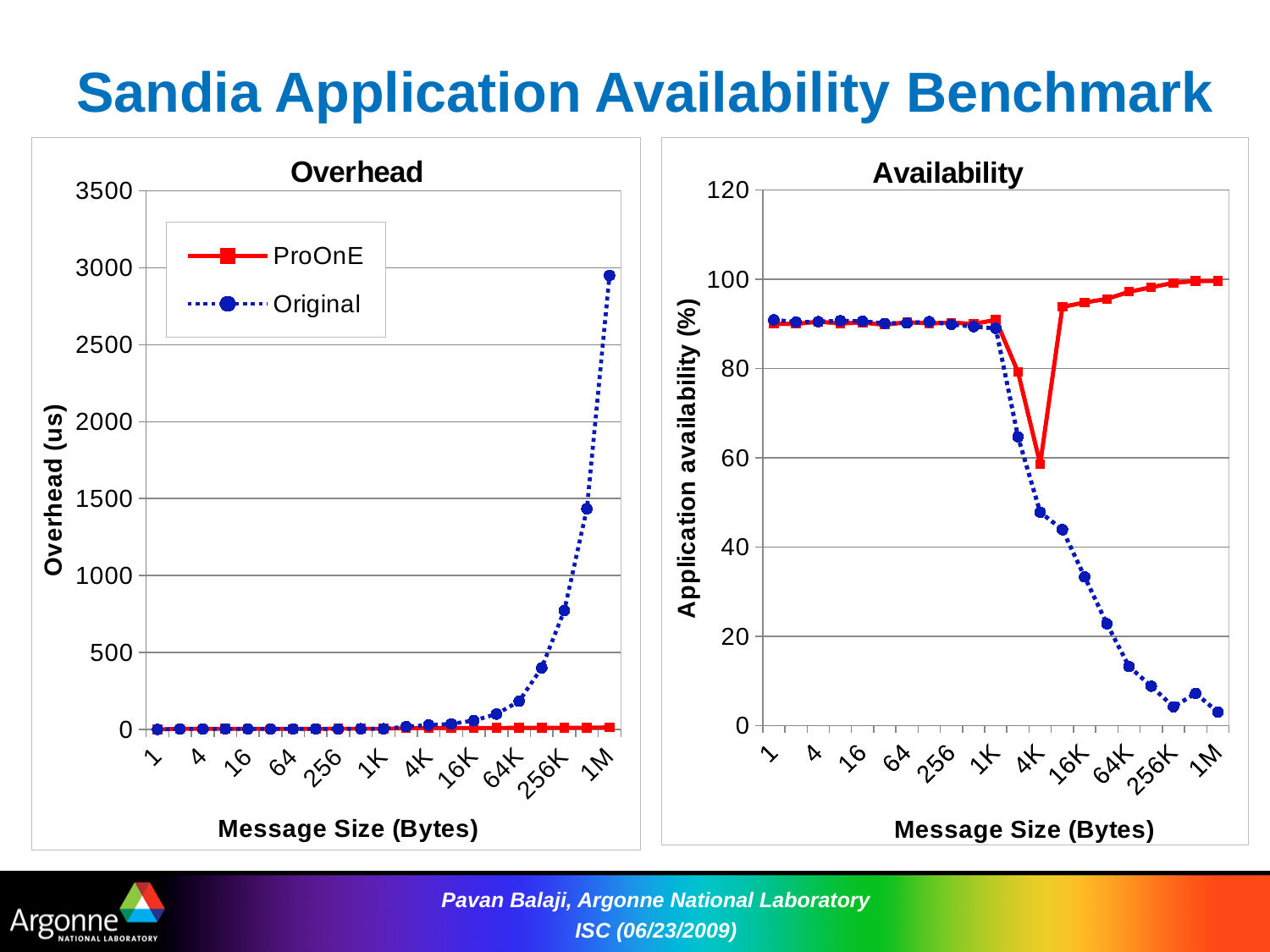
In the Overhead chart, is the Original value at message size 1M greater or less than 2500? greater In the Availability chart, does the Original series rise or fall as message size increases along the x axis? fall What is the y-axis label of the Availability chart? Application availability (%) In the Availability chart, is the Original value at message size 1M greater or less than 20? less In the Overhead chart, is the Original value at message size 256K greater or less than 1000? less In the Overhead chart, which series has the larger value at message size 1M, ProOnE or Original? Original How many message-size tick labels are shown on the x axis of the Availability chart? 11 What kind of chart is the Overhead chart on the left? line chart In the Overhead chart, does the Original series rise or fall as message size increases along the x axis? rise In the Availability chart, which series has the larger value at message size 1M, ProOnE or Original? ProOnE How many series does the legend of the Overhead chart list? 2